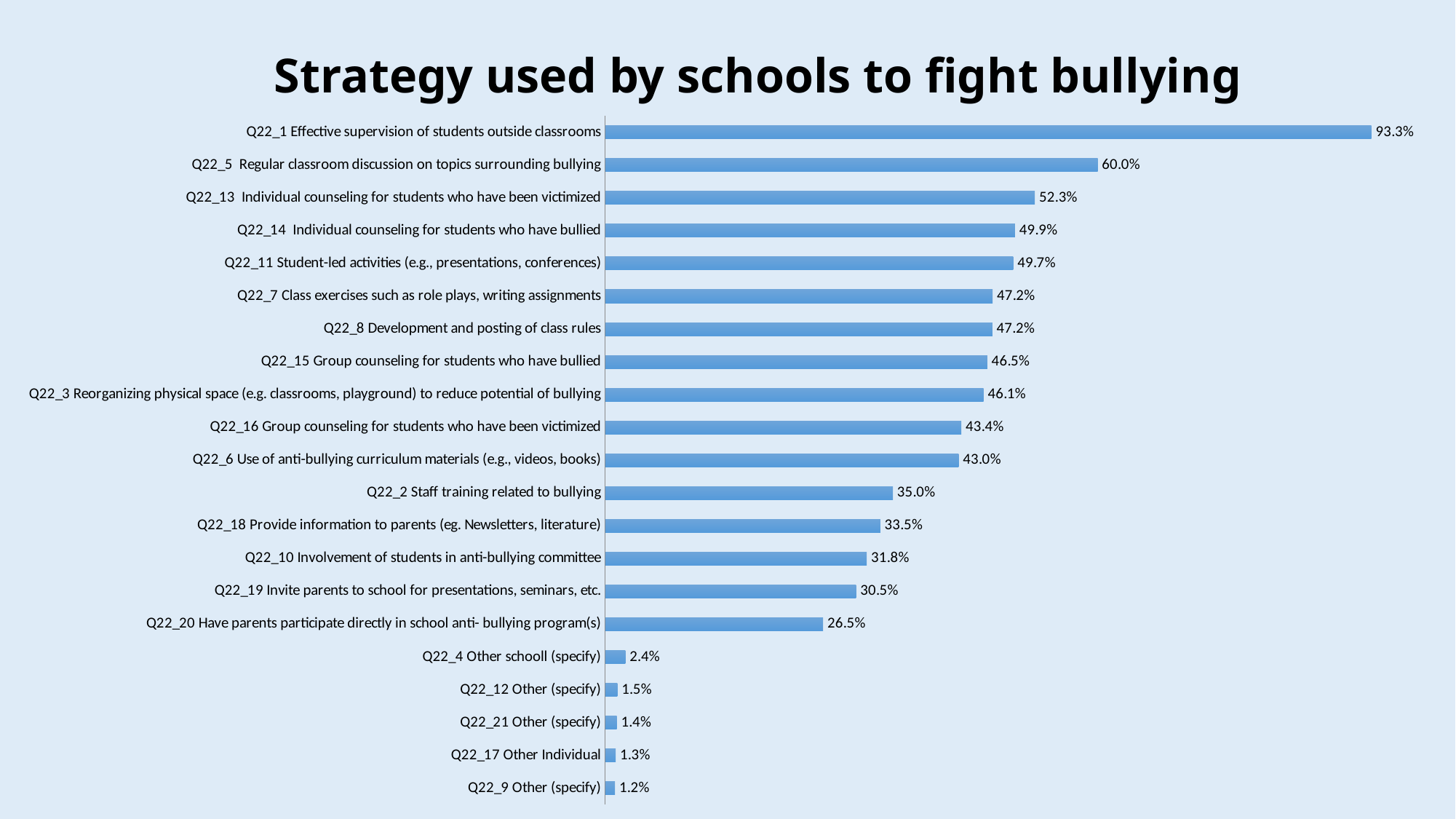
Which is larger, the value for Q22_13 Individual counseling for students who have been victimized or Q22_16 Group counseling for students who have been victimized? Q22_13 Individual counseling for students who have been victimized What is the title of the chart? Strategy used by schools to fight bullying What is the value for Q22_20 Have parents participate directly in school anti- bullying program(s)? 26.5% Which strategy has the lowest value? Q22_9 Other (specify) How many strategies (categories) are shown in the chart? 21 Which strategy has the highest value? Q22_1 Effective supervision of students outside classrooms What is the difference between the values for Q22_2 Staff training related to bullying and Q22_20 Have parents participate directly in school anti- bullying program(s)? 8.5 percentage points What is the value for Q22_4 Other schooll (specify)? 2.4% What kind of chart is shown on the slide? Bar chart What is the difference between the values for Q22_1 Effective supervision of students outside classrooms and Q22_5 Regular classroom discussion on topics surrounding bullying? 33.3 percentage points What is the value for Q22_2 Staff training related to bullying? 35.0% What is the value for Q22_1 Effective supervision of students outside classrooms? 93.3%